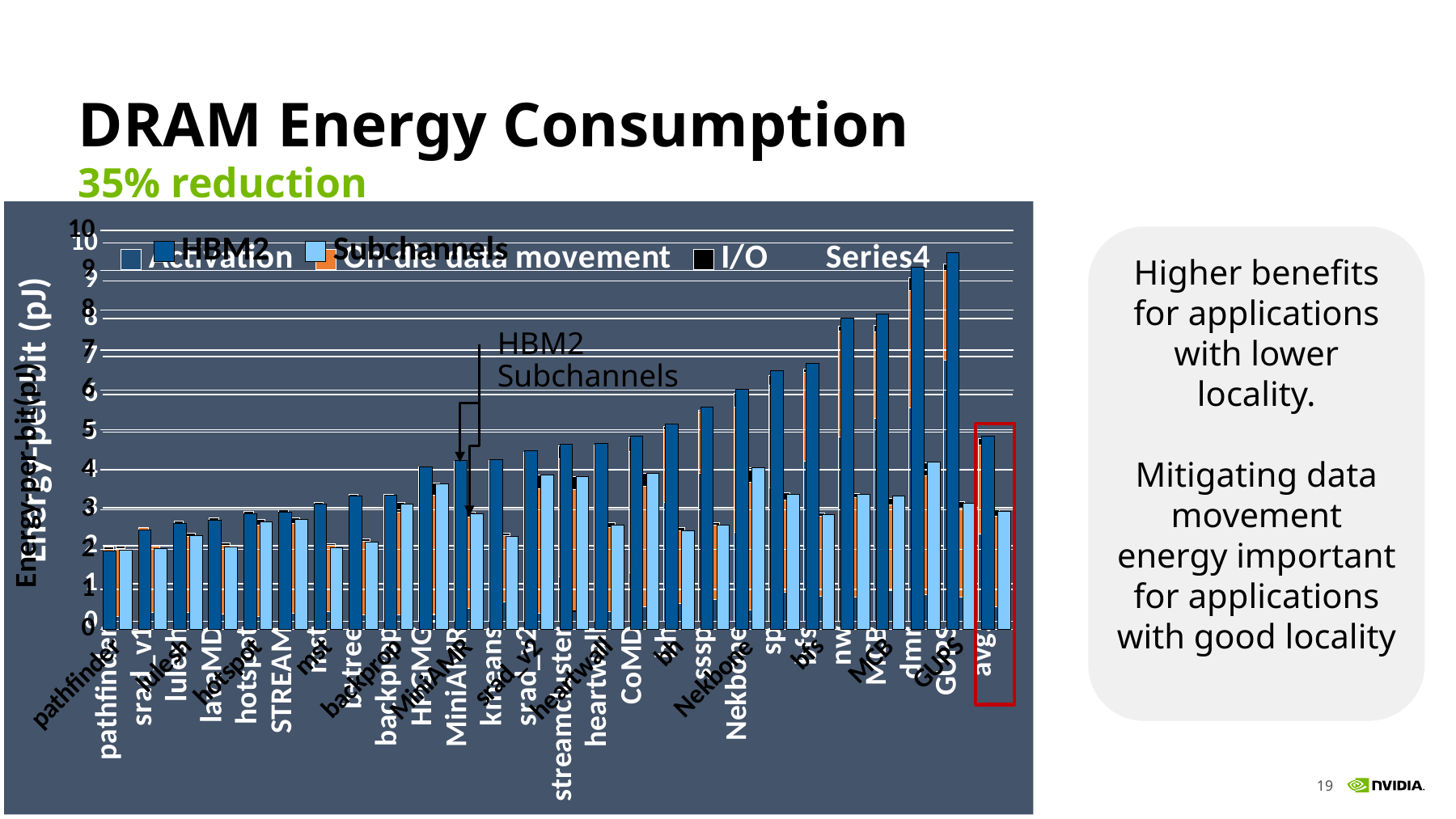
Is the HBM2 value for sp greater or less than 6? greater For GUPS, which is larger: the HBM2 value or the Subchannels value? HBM2 Which category has the lowest HBM2 value? pathfinder What kind of chart is shown on the slide? bar chart Is the Subchannels value for bh greater or less than 3? less Do the HBM2 values generally rise or fall from left to right along the x axis? rise Is the HBM2 value for avg greater or less than 4? greater What is the title of the slide containing the chart? DRAM Energy Consumption For avg, which is larger: the HBM2 value or the Subchannels value? HBM2 Which category is highlighted with a red box on the chart? avg.